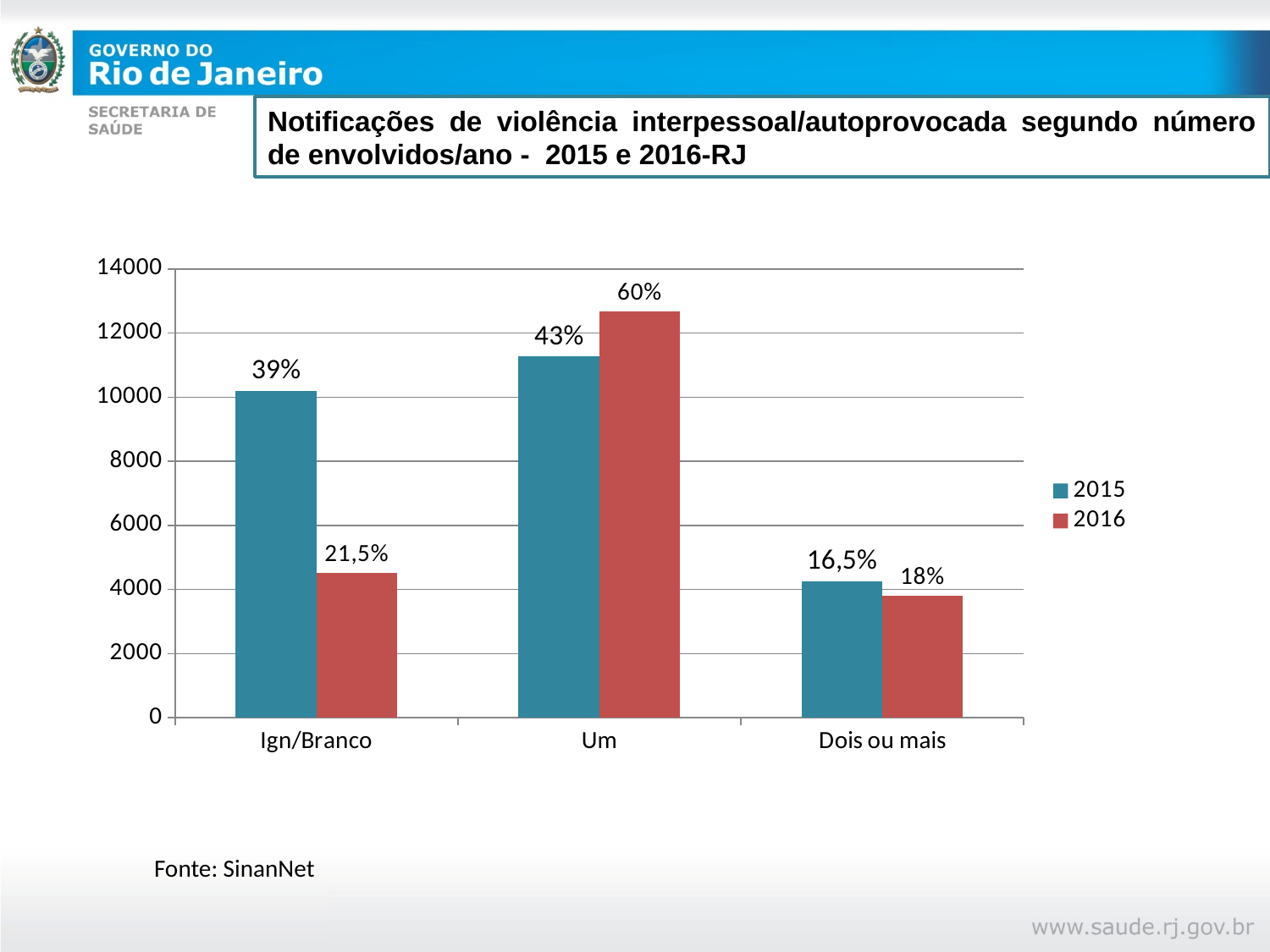
For Ign/Branco, which year has the taller bar, 2015 or 2016? 2015 What data label is printed above the 2016 bar for Ign/Branco? 21,5% How many categories are shown on the x axis of the chart? 3 Which category has the tallest bar in the chart? Um What data label is printed above the 2015 bar for Dois ou mais? 16,5% Is the value for the 2016 bar for Ign/Branco greater or less than 6000? less What data label is printed above the 2015 bar for Ign/Branco? 39% Is the value for the 2016 bar for Um greater or less than 12000? greater Which category has the shortest bar in the chart? Dois ou mais What kind of chart is shown on the slide? bar chart How many series does the chart's legend list? 2 What data label is printed above the 2016 bar for Um? 60%